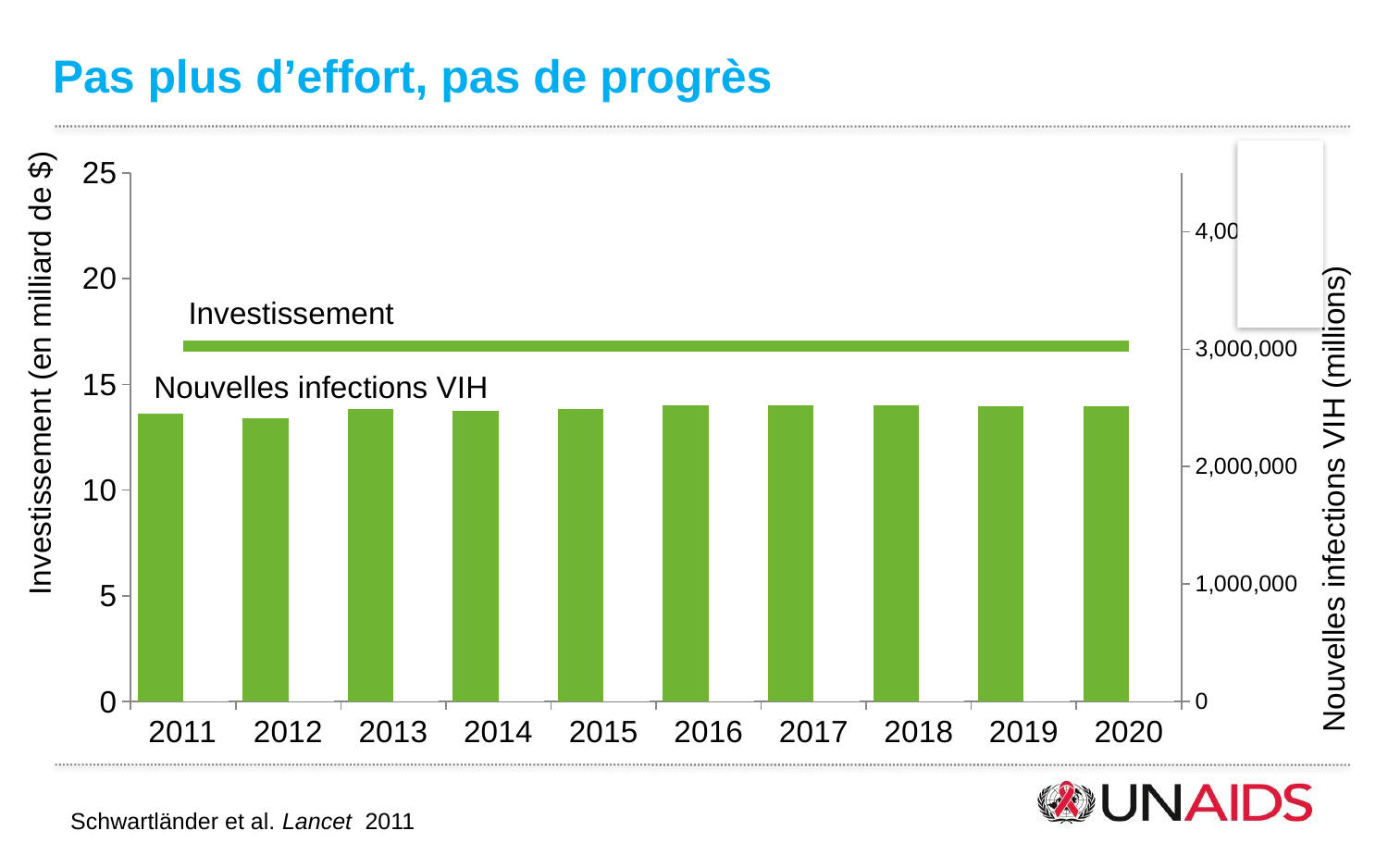
What is the label of the left vertical axis? Investissement (en milliard de $) Do the 'Nouvelles infections VIH' bars show a clear rise, a clear fall, or stay roughly flat from 2011 to 2020? roughly flat What is the title of the slide? Pas plus d'effort, pas de progrès Is the 'Nouvelles infections VIH' value for 2020 greater or less than 2,000,000? greater Is the 'Nouvelles infections VIH' value for 2011 greater or less than 1,000,000? greater Is the 'Nouvelles infections VIH' value for 2015 greater or less than 3,000,000? less What kind of chart is shown on the slide? bar chart (with a line) What is the last year shown on the x axis? 2020 How many data series are shown on the chart? 2 What is the first year shown on the x axis? 2011 Does the 'Investissement' line rise, fall, or stay flat from 2011 to 2020? stays flat How many years are shown along the x axis? 10